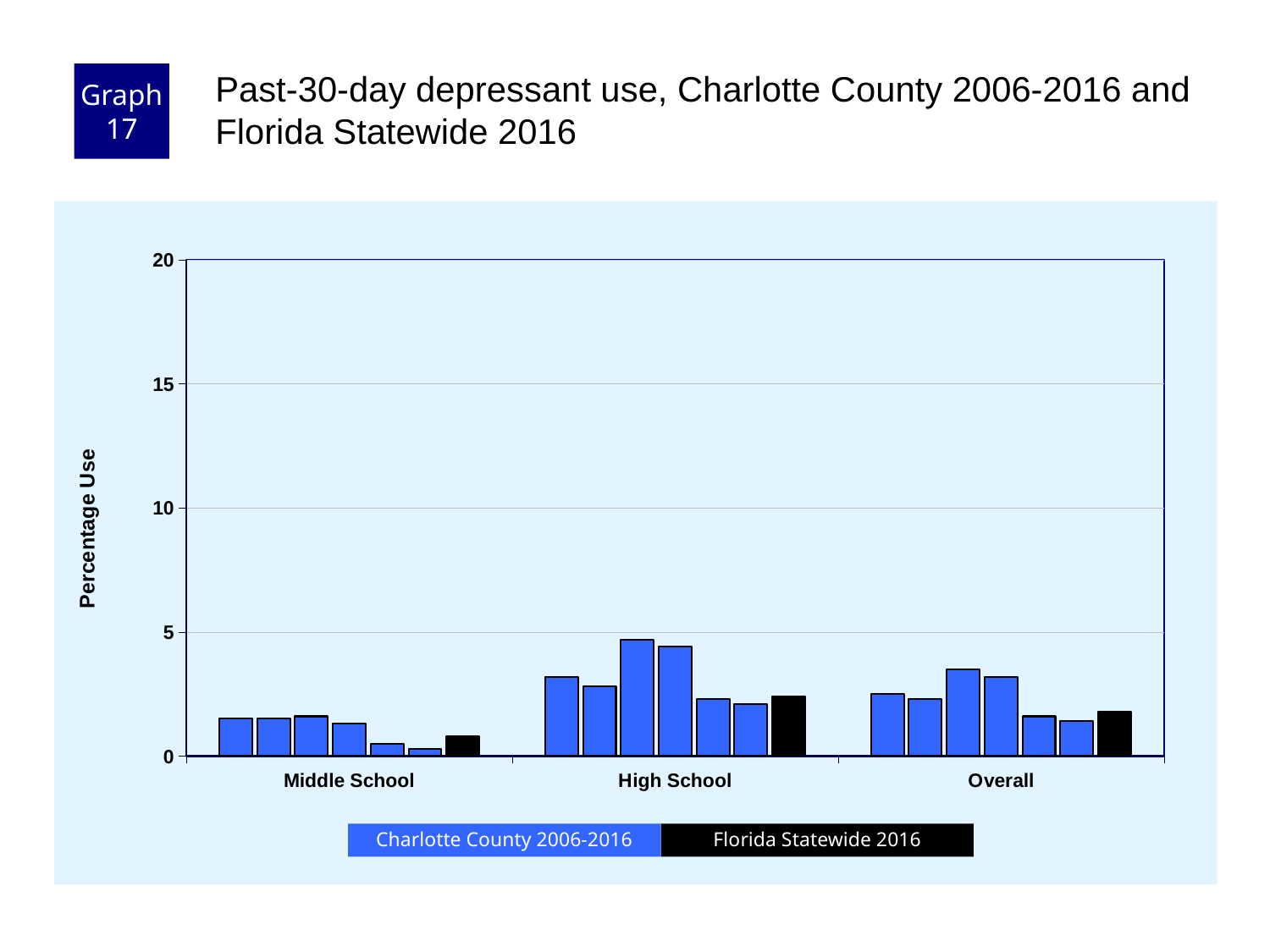
Is the Florida Statewide 2016 value for High School greater or less than 5? less What is the label on the y axis of the chart? Percentage Use Which category has the lowest Florida Statewide 2016 value? Middle School Which is larger, the Florida Statewide 2016 value for High School or for Overall? High School Are any of the bars in the chart above 10 on the y axis? No Which colour represents Florida Statewide 2016 in the chart legend? black What kind of chart is shown on the slide? bar chart Which is larger, the Florida Statewide 2016 value for Middle School or for Overall? Overall Which category has the highest Florida Statewide 2016 value? High School How many series does the chart legend list? 2 Is the Florida Statewide 2016 value for Overall greater or less than 5? less How many categories are shown on the x axis of the chart? 3